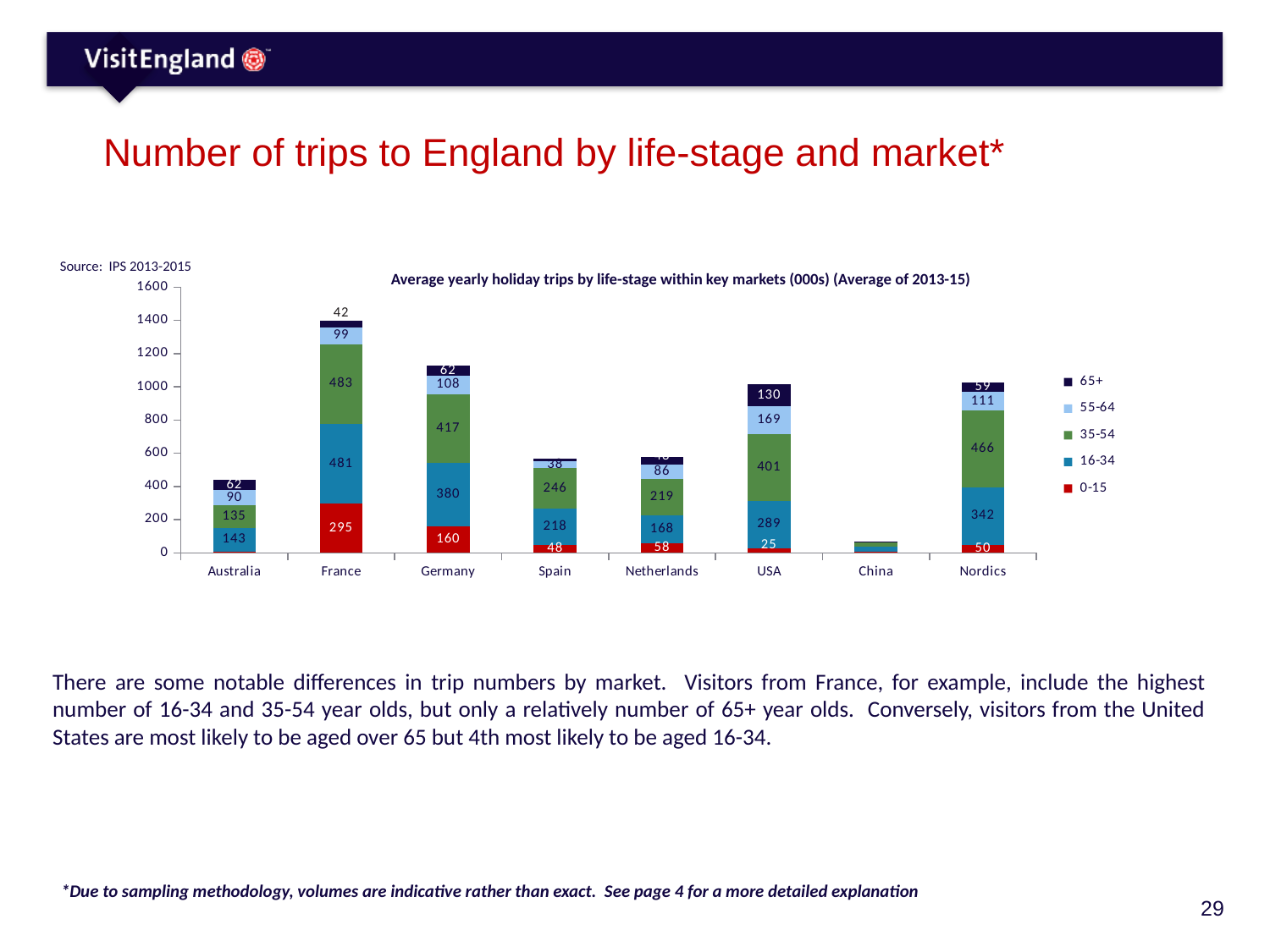
What is the value for the 35-54 segment for the Nordics? 466 Is the total bar for China greater or less than 200? less Which market has the highest value for the 35-54 segment? France How many markets are shown on the x axis? 8 What is the total of the stacked bar for France? 1400 Which market has the tallest stacked bar overall? France What is the difference between the 35-54 and 16-34 segments for Germany? 37 What kind of chart is shown on the slide? Stacked bar chart What is the value for the 16-34 segment for France? 481 What is the value for the 65+ segment for the USA? 130 How many series does the legend list? 5 Which is larger, the 16-34 segment for the USA or the 16-34 segment for the Nordics? Nordics